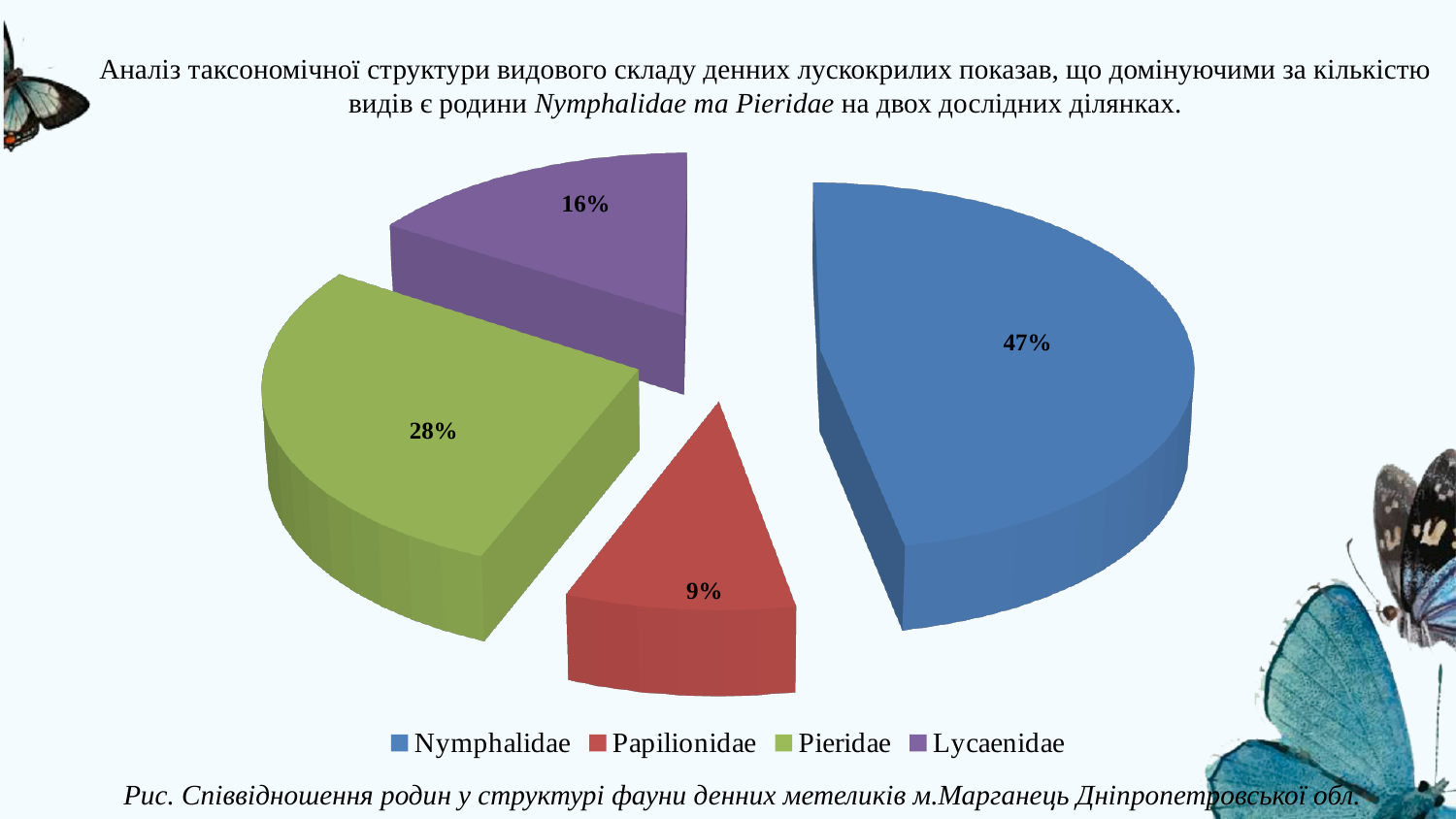
What share of the pie does Papilionidae have? 9% What colour is the Pieridae slice? Green What share of the pie does Pieridae have? 28% What is the difference in percentage points between the Nymphalidae and Pieridae shares? 19 What kind of chart is shown on the slide? Pie chart Which has a larger share, Pieridae or Lycaenidae? Pieridae How many families (slices) are shown in the pie chart? 4 Which family has the largest share of the pie? Nymphalidae What share of the pie does Nymphalidae have? 47% What share of the pie does Lycaenidae have? 16% Which family has the smallest share of the pie? Papilionidae What is the combined share of Nymphalidae and Pieridae? 75%